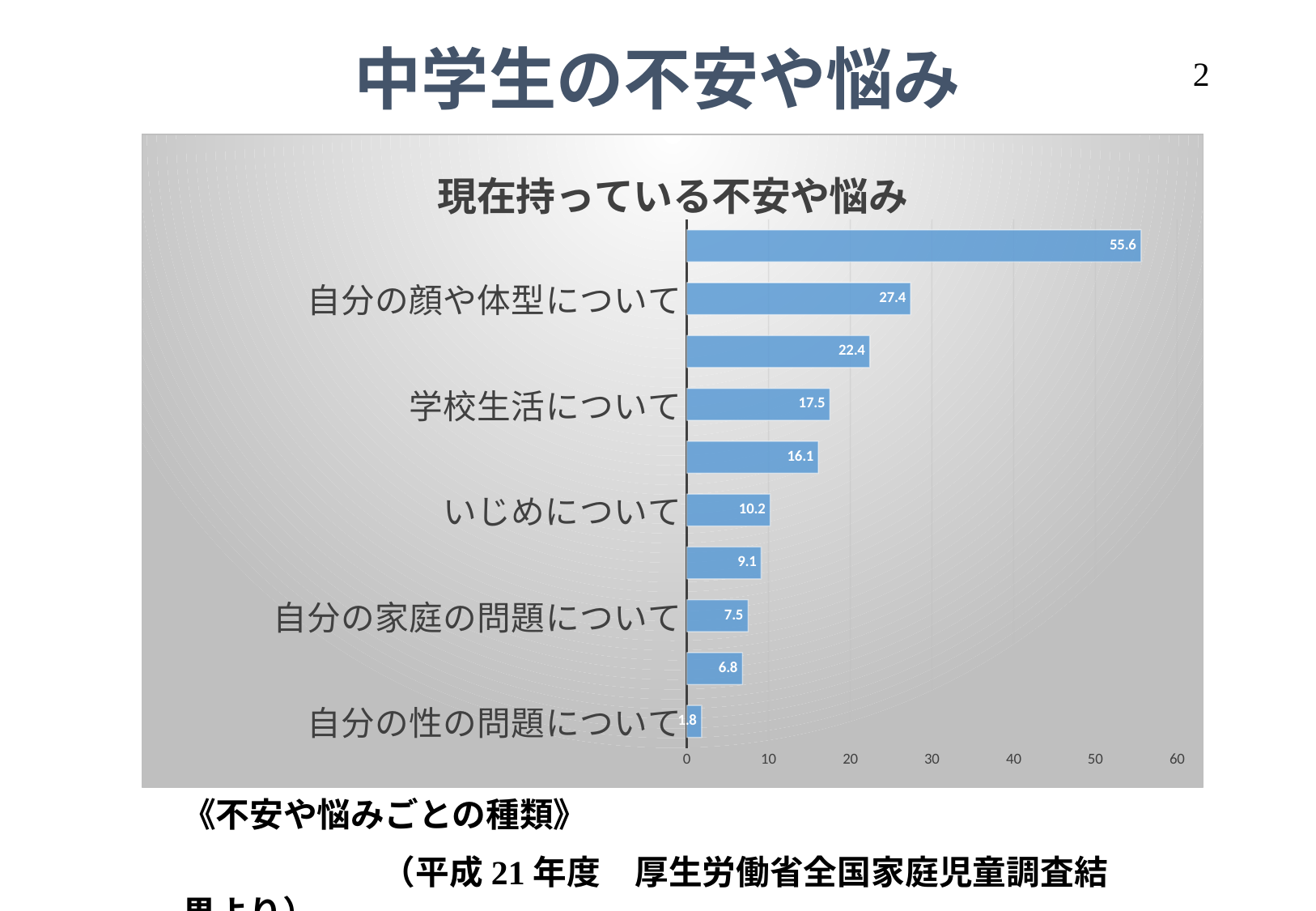
What is the value for いじめについて? 10.2 What is the value for 自分の家庭の問題について? 7.5 Which labelled category has the lowest value? 自分の性の問題について How many bars are plotted on the chart? 10 What is the value for 自分の顔や体型について? 27.4 Is the value for 自分の顔や体型について greater or less than 20? greater What is the title of the chart? 現在持っている不安や悩み What is the largest value shown on the chart? 55.6 Which is larger, the value for いじめについて or the value for 自分の家庭の問題について? いじめについて What is the difference between the values for 自分の顔や体型について and 学校生活について? 9.9 What is the value for 学校生活について? 17.5 What kind of chart is shown on the slide? bar chart